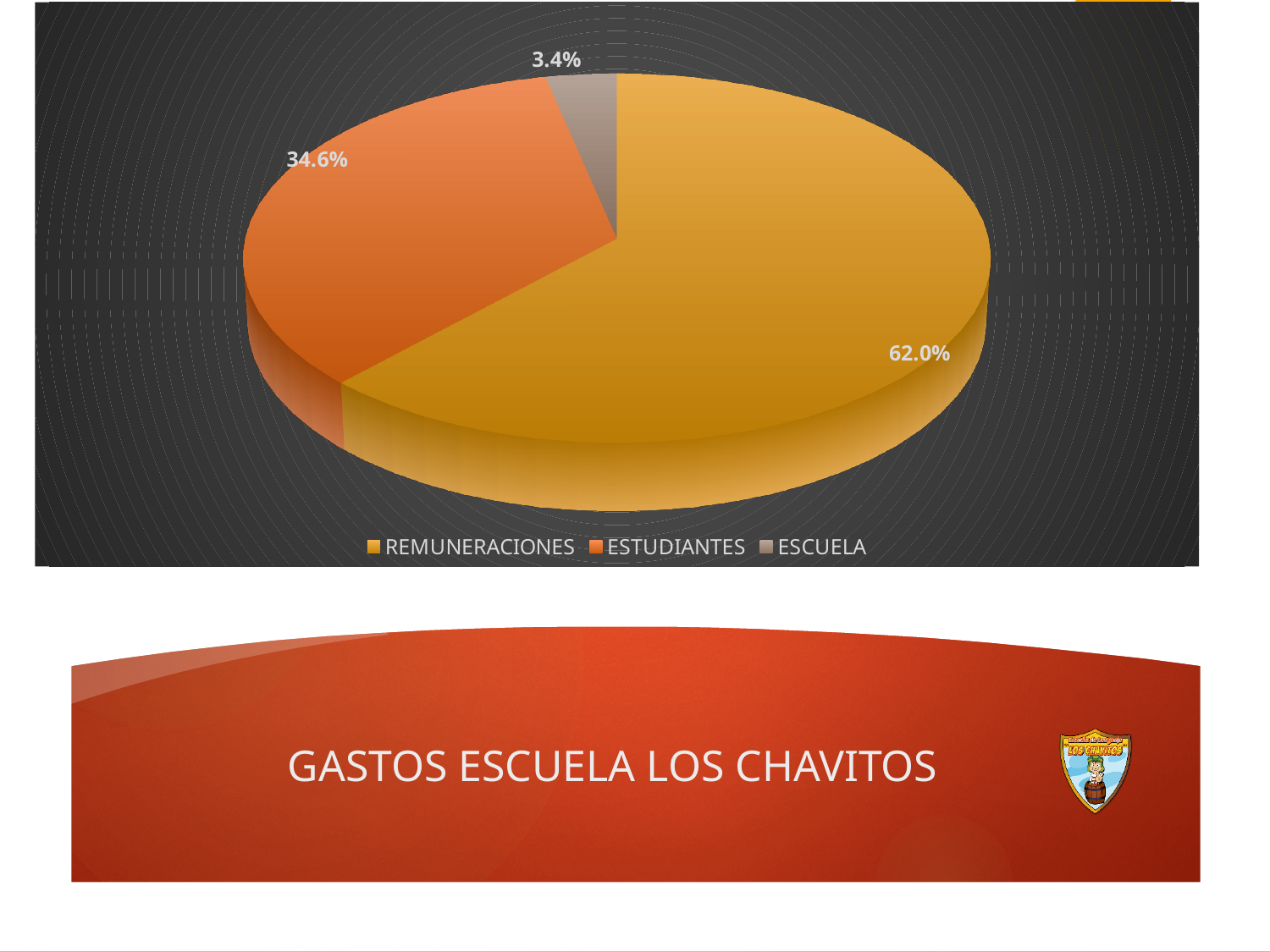
What is the title text shown below the chart on the slide? GASTOS ESCUELA LOS CHAVITOS What is the difference in percentage points between the REMUNERACIONES and ESTUDIANTES slices? 27.4 What share of the pie does REMUNERACIONES represent? 62.0% What is the difference in percentage points between the ESTUDIANTES and ESCUELA slices? 31.2 What kind of chart is shown on the slide? Pie chart Which slice is larger, ESTUDIANTES or ESCUELA? ESTUDIANTES What share of the pie does ESTUDIANTES represent? 34.6% Which category has the largest slice of the pie? REMUNERACIONES What share of the pie does ESCUELA represent? 3.4% How many categories are shown in the pie chart? 3 Which category has the smallest slice of the pie? ESCUELA What colour is the ESTUDIANTES slice in the pie chart? Orange